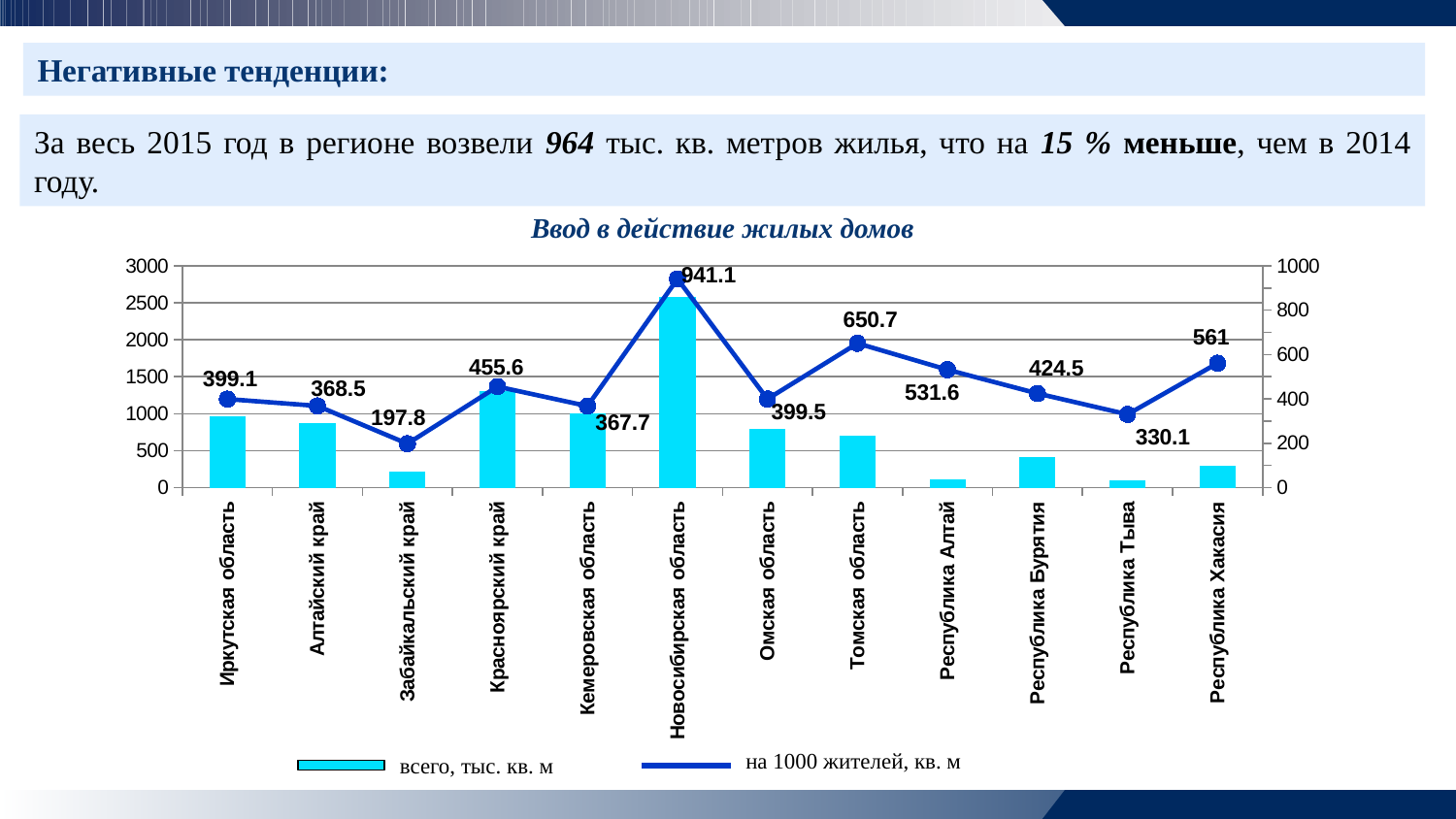
What is the value of 'на 1000 жителей, кв. м' for Новосибирская область? 941.1 Which region has the lowest value for 'на 1000 жителей, кв. м'? Забайкальский край Is the 'всего, тыс. кв. м' bar for Республика Тыва greater or less than 500? less What is the difference between the 'на 1000 жителей, кв. м' values for Новосибирская область and Томская область? 290.4 Which region has the highest value for 'на 1000 жителей, кв. м'? Новосибирская область What is the value of 'на 1000 жителей, кв. м' for Республика Тыва? 330.1 How many series does the chart legend list? 2 Is the 'всего, тыс. кв. м' bar for Новосибирская область greater or less than 2000? greater How many regions are shown on the x axis of the chart? 12 What is the title of the chart? Ввод в действие жилых домов What is the value of 'на 1000 жителей, кв. м' for Томская область? 650.7 Which has a larger 'на 1000 жителей, кв. м' value: Республика Алтай or Республика Бурятия? Республика Алтай